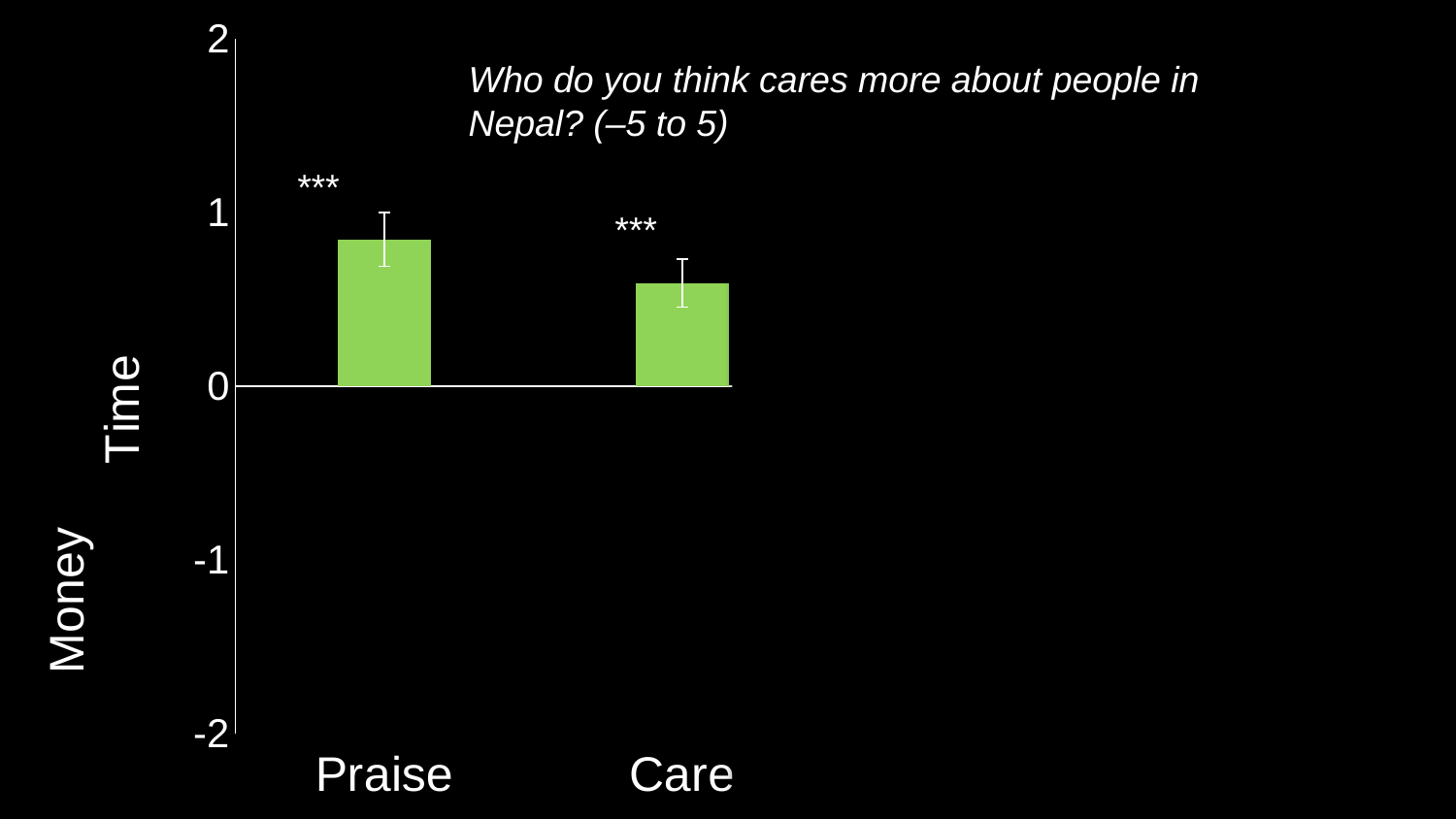
Which category has the lowest bar? Care Is the value for Care greater or less than 1? less What is the highest value shown on the y axis? 2 Is the value for Praise greater or less than 0? greater Is the value for Care greater or less than 0? greater How many categories are plotted on the x axis? 2 What question is written as the chart's title? Who do you think cares more about people in Nepal? (–5 to 5) Which bar is taller, Praise or Care? Praise What kind of chart is shown on the slide? bar chart Which category has the highest bar? Praise